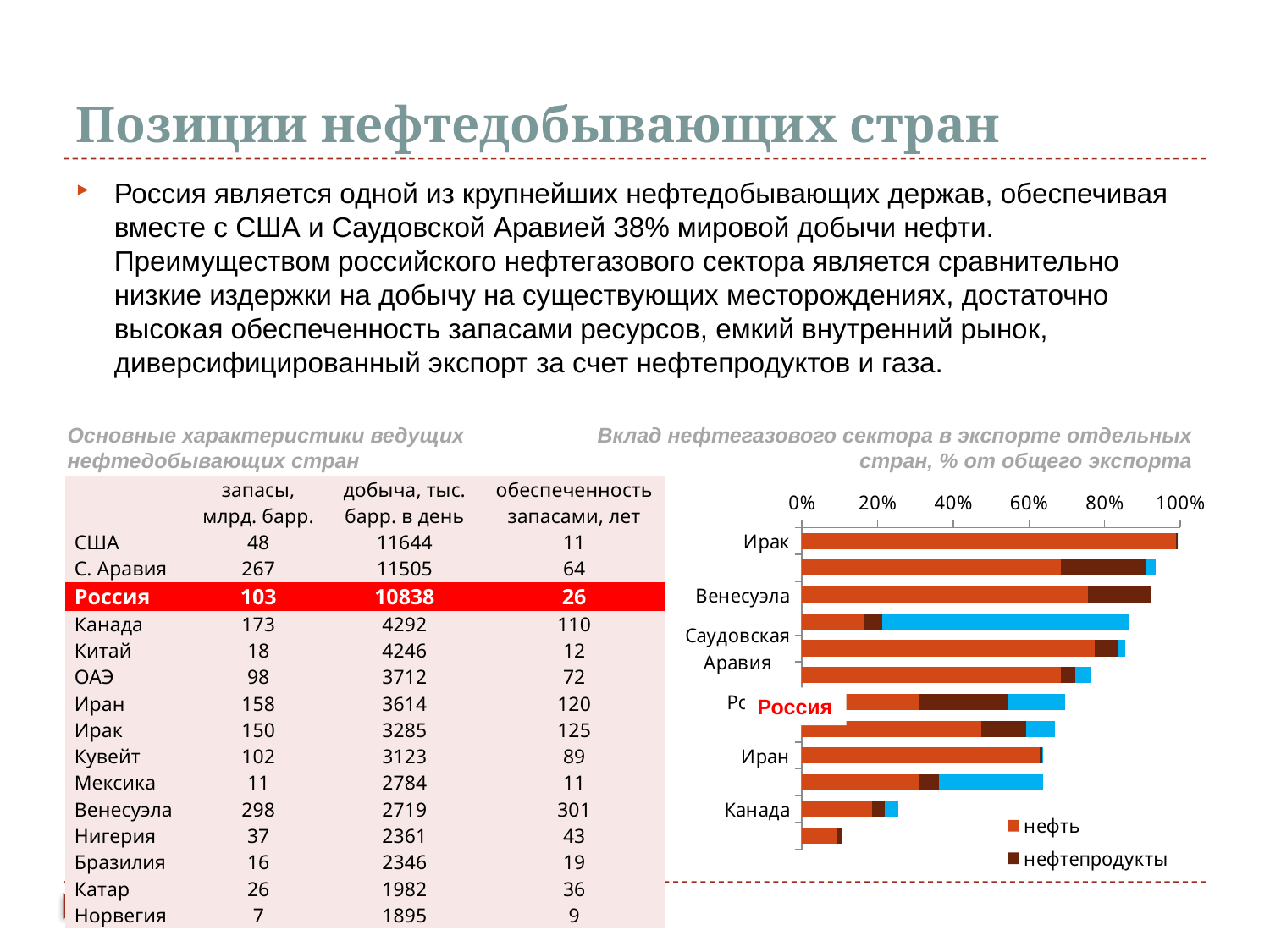
What kind of chart is shown on the right side of the slide? bar chart In the chart on the right, is the total bar for Венесуэла greater or less than 80%? greater In the chart on the right, which legend entries are shown? нефть, нефтепродукты What is the title of the chart on the right side of the slide? Вклад нефтегазового сектора в экспорте отдельных стран, % от общего экспорта In the chart on the right, which has the larger total bar, Венесуэла or Иран? Венесуэла In the chart on the right, is the total bar for Канада greater or less than 40%? less In the chart on the right, is the total bar for Иран greater or less than 40%? greater In the chart on the right, which has the larger total bar, Ирак or Канада? Ирак In the chart on the right, which labelled country has the highest total bar? Ирак In the chart on the right, which labelled country has the lowest total bar? Канада